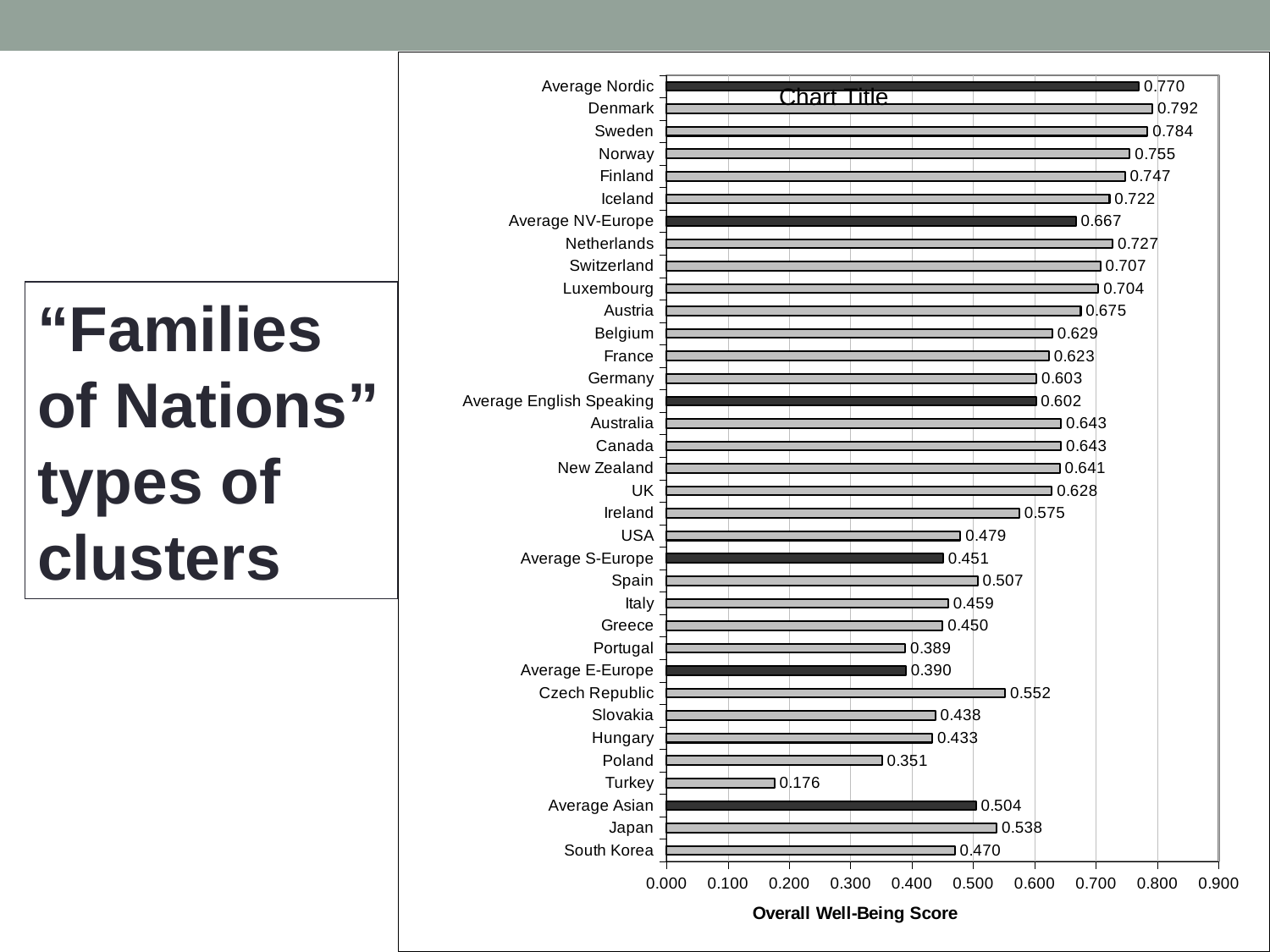
What kind of chart is shown on the slide? Bar chart Which category has the lowest Overall Well-Being Score? Turkey Is the value for Czech Republic greater or less than 0.500? greater Which has a higher Overall Well-Being Score, Japan or South Korea? Japan What is the difference between the scores for Sweden and Norway? 0.029 What is the Overall Well-Being Score for Denmark? 0.792 What is the label on the horizontal axis of the chart? Overall Well-Being Score Which category has the highest Overall Well-Being Score? Denmark What is the Overall Well-Being Score for Turkey? 0.176 How many categories are plotted on the chart? 35 What is the value shown for Average English Speaking? 0.602 What is the difference between the scores for Average Nordic and Average Asian? 0.266